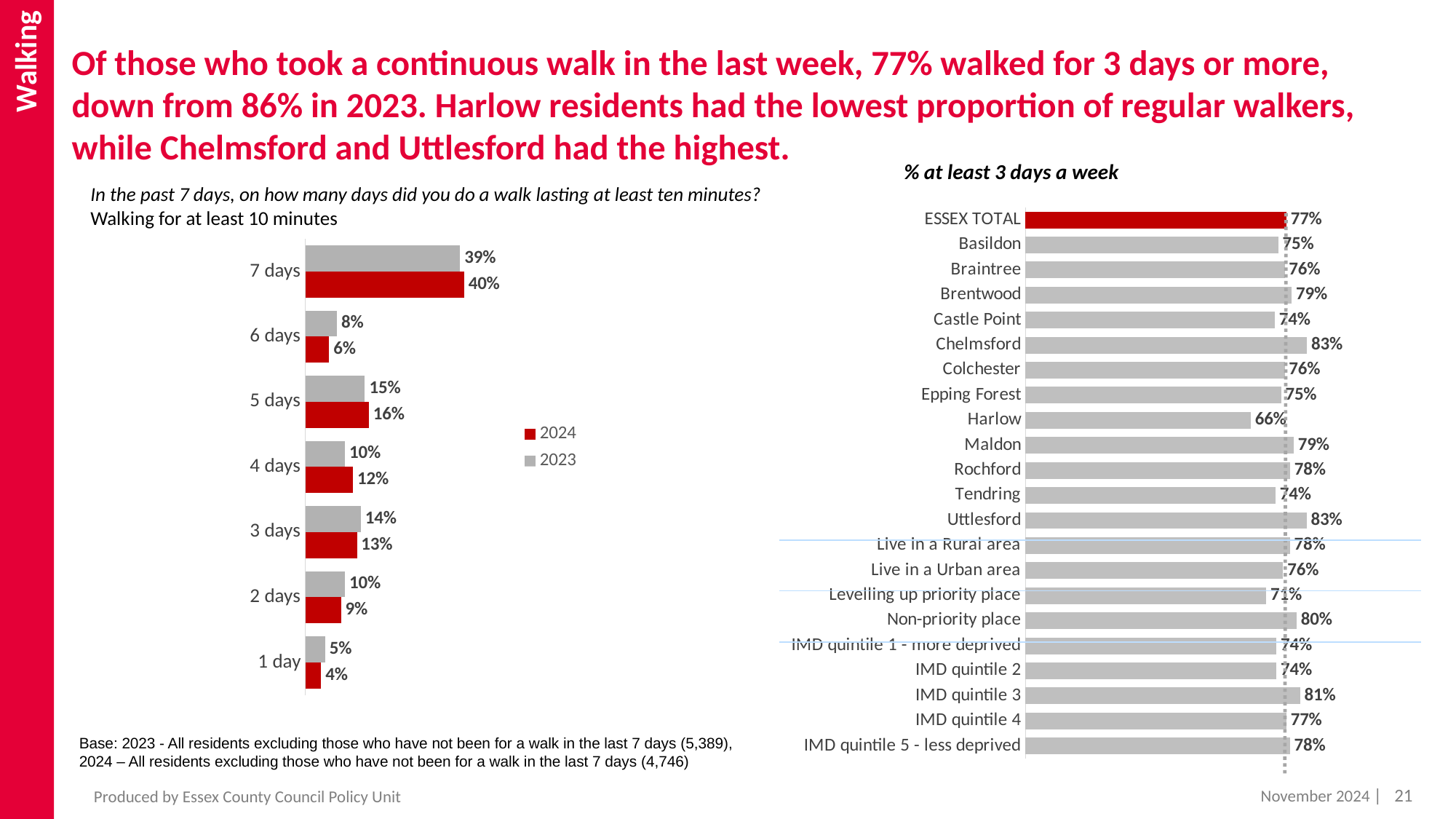
In the '% at least 3 days a week' chart, what is the difference between Chelmsford and Castle Point? 9% In the '% at least 3 days a week' chart, which is larger, IMD quintile 3 or IMD quintile 2? IMD quintile 3 What kind of chart is the 'Walking for at least 10 minutes' chart? bar chart In the 'Walking for at least 10 minutes' chart, what is the 2023 value for 5 days? 15% In the 'Walking for at least 10 minutes' chart, what is the 2024 value for 7 days? 40% In the 'Walking for at least 10 minutes' chart, is the 2024 value for 4 days larger or smaller than the 2023 value for 4 days? larger How many series does the legend of the 'Walking for at least 10 minutes' chart list? 2 In the 'Walking for at least 10 minutes' chart, what is the difference between the 2023 and 2024 values for 6 days? 2% In the '% at least 3 days a week' chart, what is the value for ESSEX TOTAL? 77% In the '% at least 3 days a week' chart, which area has the lowest value? Harlow In the '% at least 3 days a week' chart, what is the value for Harlow? 66% In the 'Walking for at least 10 minutes' chart, which category has the lowest 2024 value? 1 day